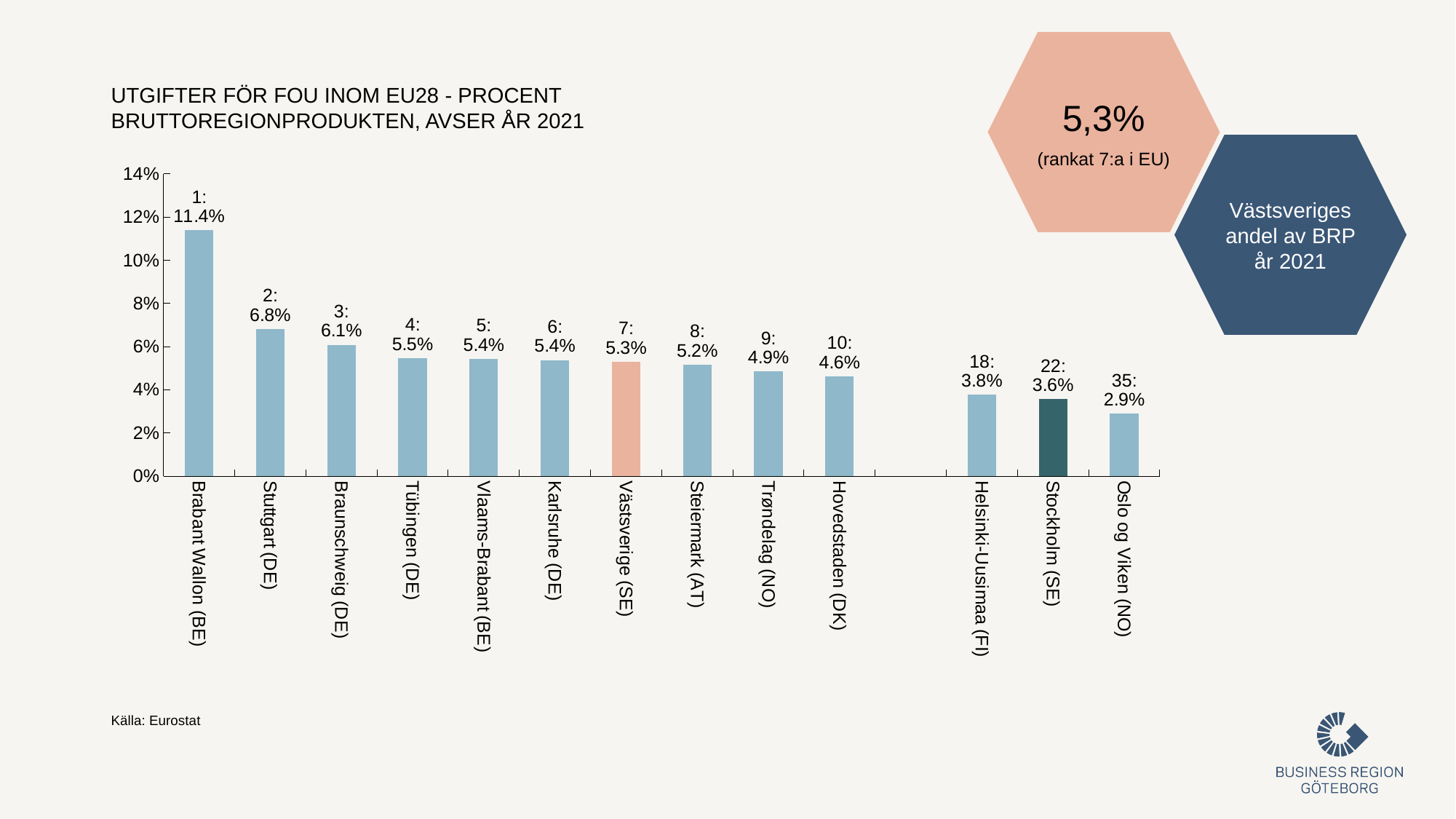
What rank is shown above the bar for Trøndelag (NO)? 9 What is the difference between Västsverige (SE) and Stockholm (SE)? 1.7% What is the value for Stockholm (SE)? 3.6% What is the value for Stuttgart (DE)? 6.8% Which region has the highest value? Brabant Wallon (BE) What is the difference between Brabant Wallon (BE) and Stuttgart (DE)? 4.6% Is the value for Helsinki-Uusimaa (FI) greater or less than 4%? less How many regions are shown in the chart? 13 What kind of chart is shown on the slide? bar chart Which is larger, the value for Braunschweig (DE) or the value for Hovedstaden (DK)? Braunschweig (DE) Which region has the lowest value? Oslo og Viken (NO) What is the value for Västsverige (SE)? 5.3%